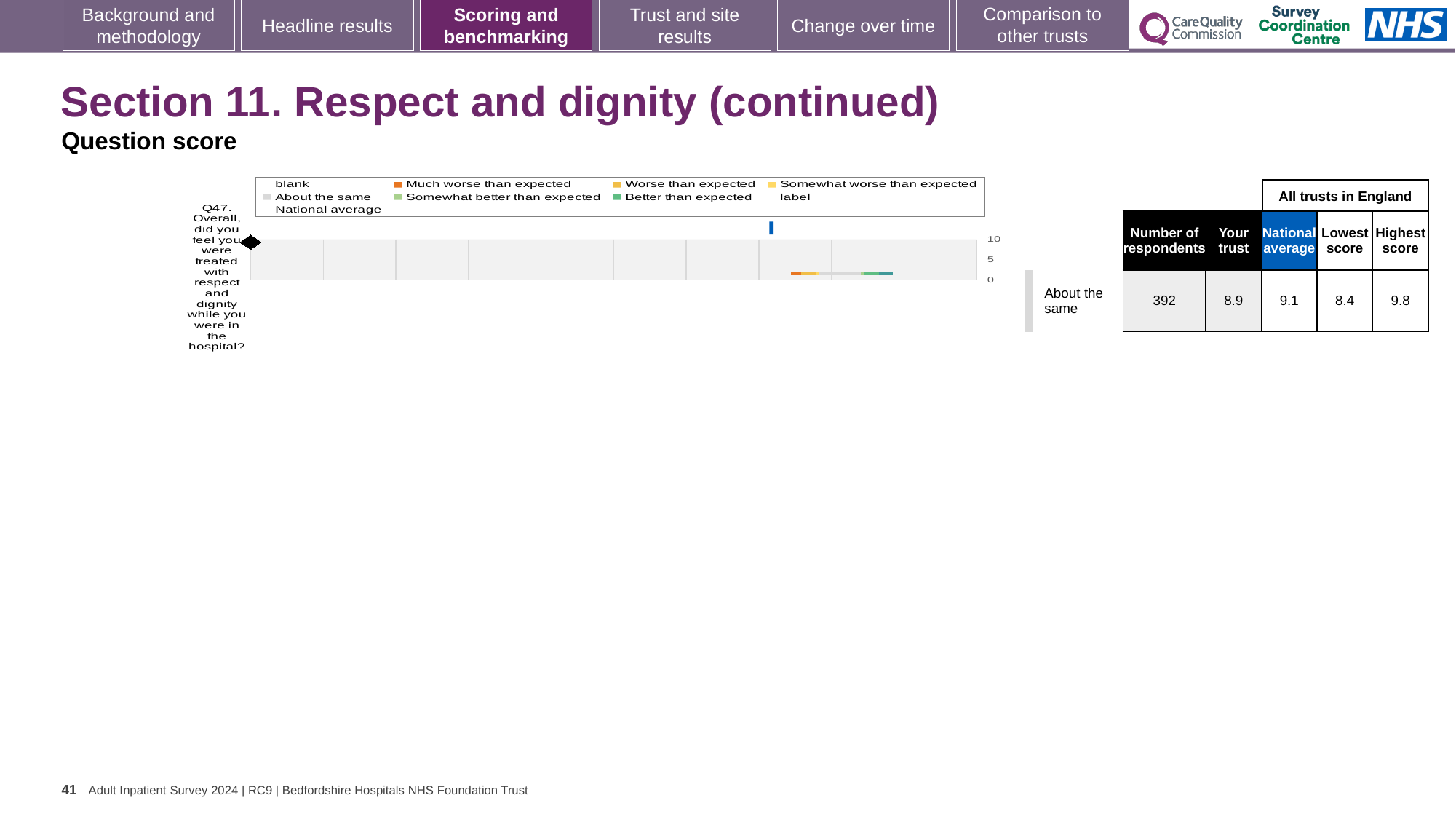
How many respondents answered Q47? 392 What kind of chart is shown on the slide? bar chart What is the national average score for Q47 shown in the table next to the chart? 9.1 What is the lowest score among all trusts in England for Q47? 8.4 How many questions (categories) are plotted on the chart? 1 Which question number is plotted on the chart? Q47 What is the highest tick value shown on the chart's score axis? 10 What benchmark category is the trust's Q47 score placed in? About the same What is the difference between the highest score and the lowest score for Q47? 1.4 What is the highest score among all trusts in England for Q47? 9.8 Which is larger for Q47, the 'Your trust' score or the national average? National average What is the 'Your trust' score for Q47 shown in the table next to the chart? 8.9